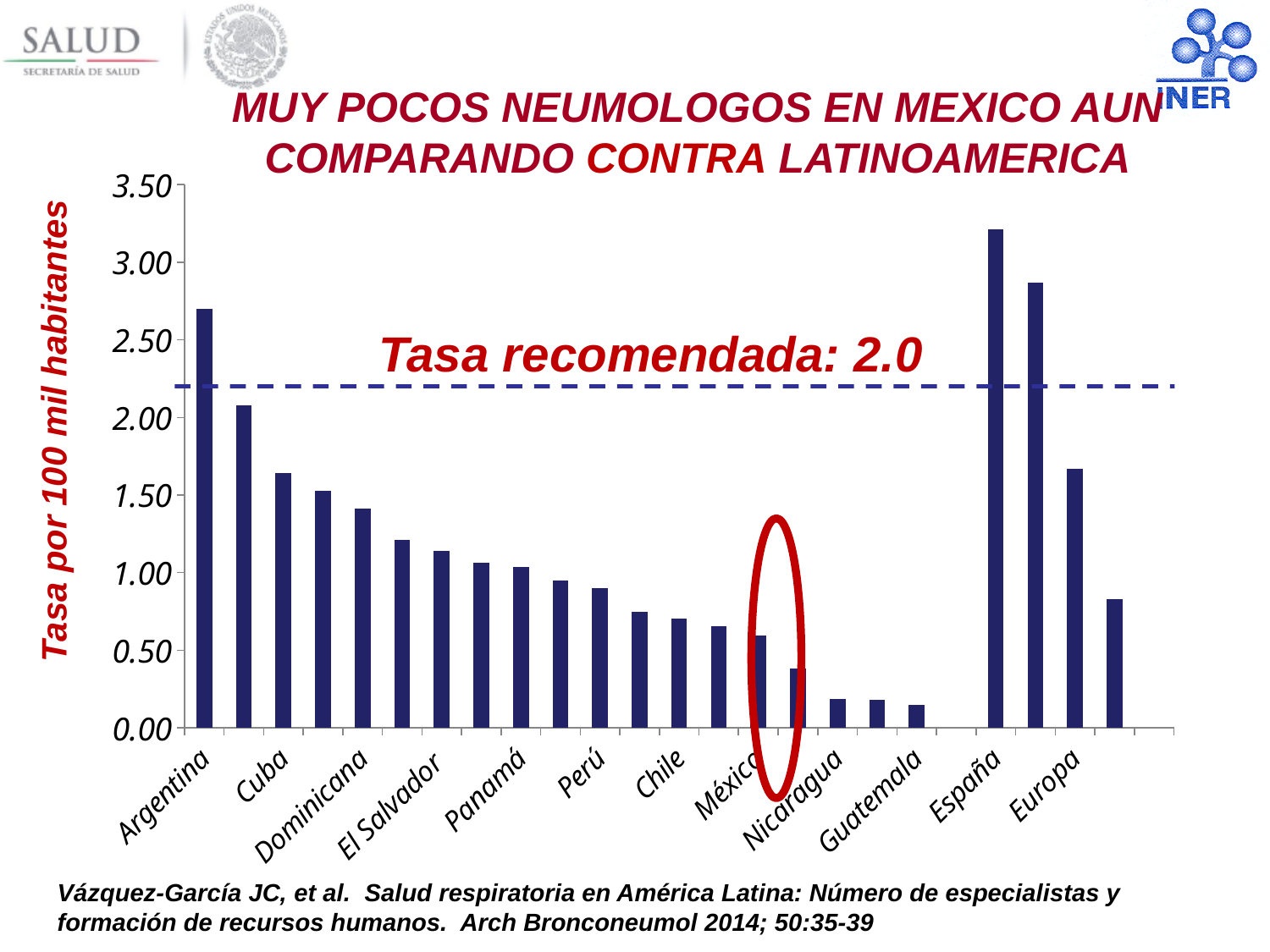
What kind of chart is shown on the slide? bar chart Is the value for Dominicana greater or less than 1.00? greater Which has a higher rate, España or Europa? España Is the value for Guatemala greater or less than 0.50? less Which has a higher rate, Argentina or Cuba? Argentina Is the value for Chile greater or less than 1.00? less What is the recommended rate (tasa recomendada) indicated on the chart? 2.0 Which country or region has the highest rate in the chart? España Do the bars rise or fall from Argentina to Guatemala along the x axis? fall What is the label of the vertical axis? Tasa por 100 mil habitantes